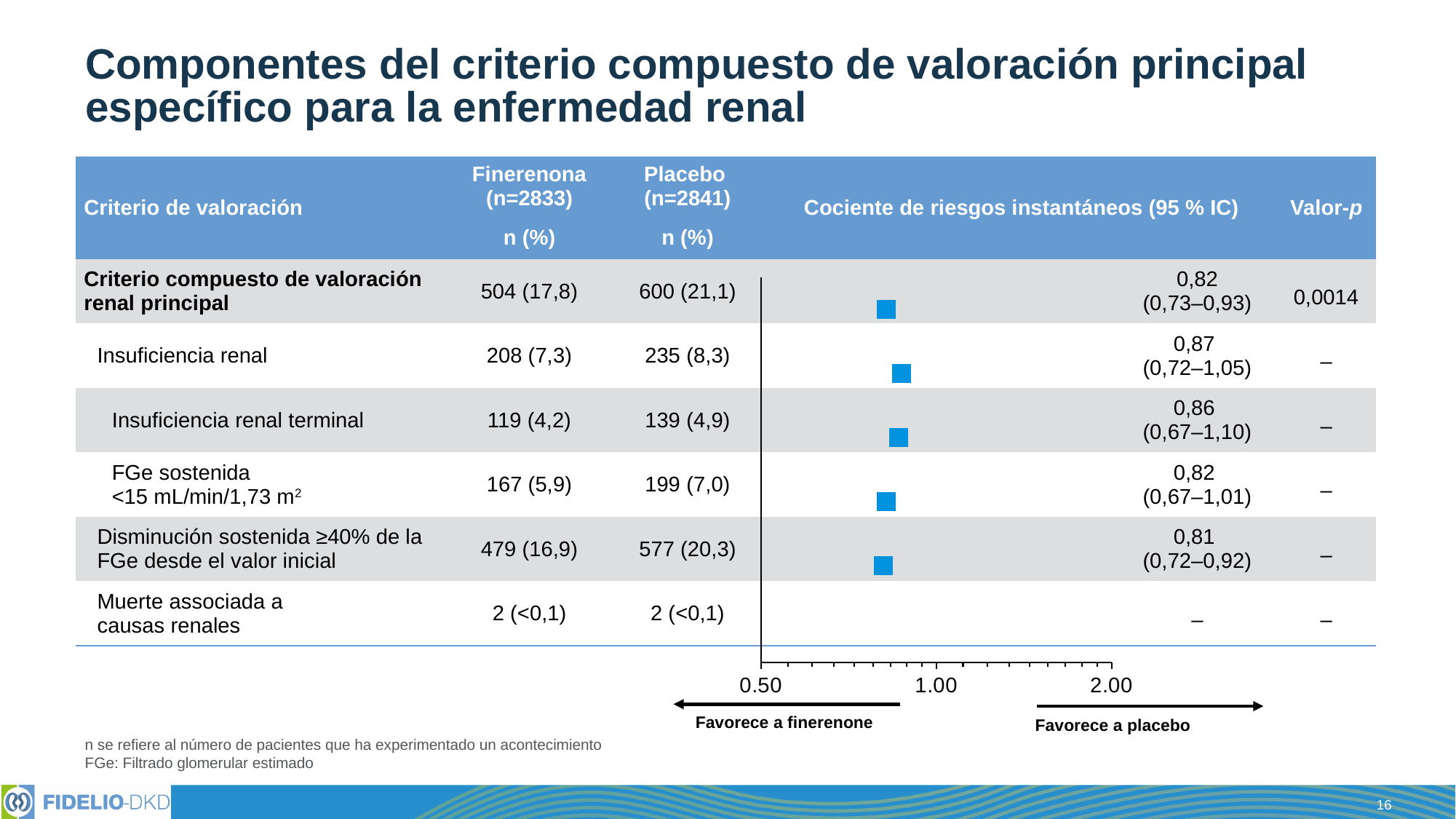
What is the hazard ratio shown for 'Insuficiencia renal terminal'? 0,86 How many endpoints have a hazard ratio point plotted on the forest plot? 5 Is the hazard ratio for 'Insuficiencia renal terminal' greater or less than 1.00? less What is the p-value shown for the 'Criterio compuesto de valoración renal principal'? 0,0014 What kind of chart is shown alongside the table? Forest plot Which endpoint has the highest plotted hazard ratio? Insuficiencia renal What is the hazard ratio (cociente de riesgos instantáneos) plotted for 'Criterio compuesto de valoración renal principal'? 0,82 What is the 95% confidence interval shown for 'Insuficiencia renal'? (0,72–1,05) What is the hazard ratio shown for 'Disminución sostenida ≥40% de la FGe desde el valor inicial'? 0,81 What is the difference between the hazard ratios for 'Insuficiencia renal' and 'Disminución sostenida ≥40% de la FGe desde el valor inicial'? 0,06 Which has the larger hazard ratio: 'Insuficiencia renal' or 'FGe sostenida <15 mL/min/1,73 m2'? Insuficiencia renal Which endpoint has the lowest plotted hazard ratio? Disminución sostenida ≥40% de la FGe desde el valor inicial